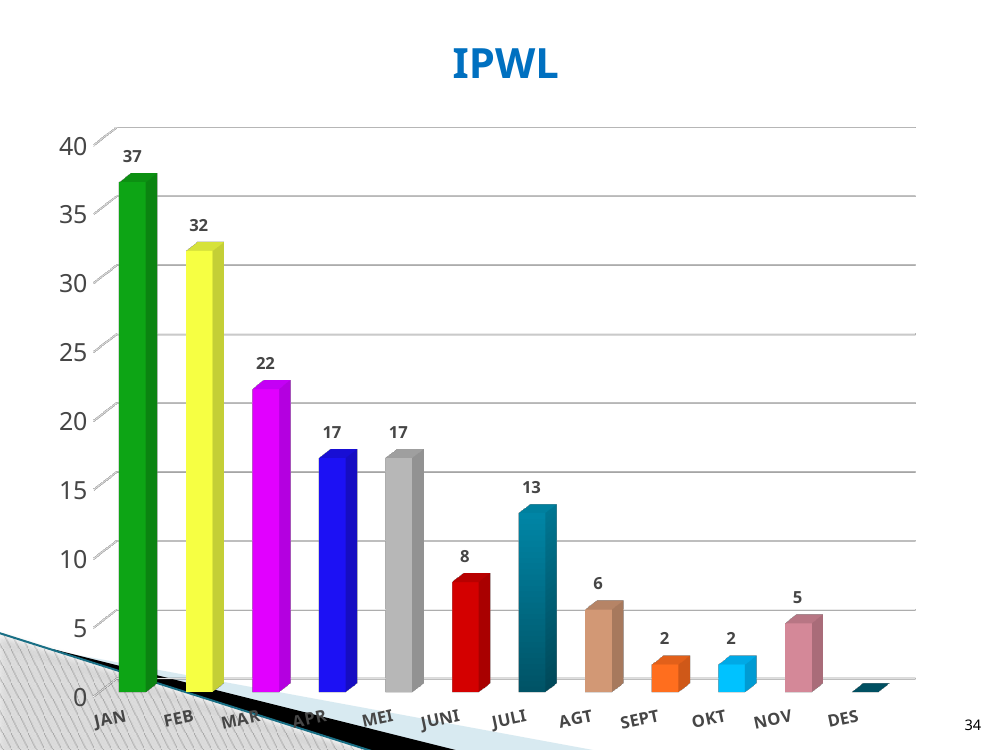
What is the value for JAN? 37 Which month has the highest value? JAN What is the difference between the values for MAR and AGT? 16 What is the value for NOV? 5 What is the value for MAR? 22 What is the title of the chart? IPWL Is the value for FEB greater or less than 30? greater What is the difference between the values for JAN and FEB? 5 What kind of chart is this? bar chart Which is larger, the value for JUNI or the value for JULI? JULI What is the value for JULI? 13 How many months are shown on the x axis? 12